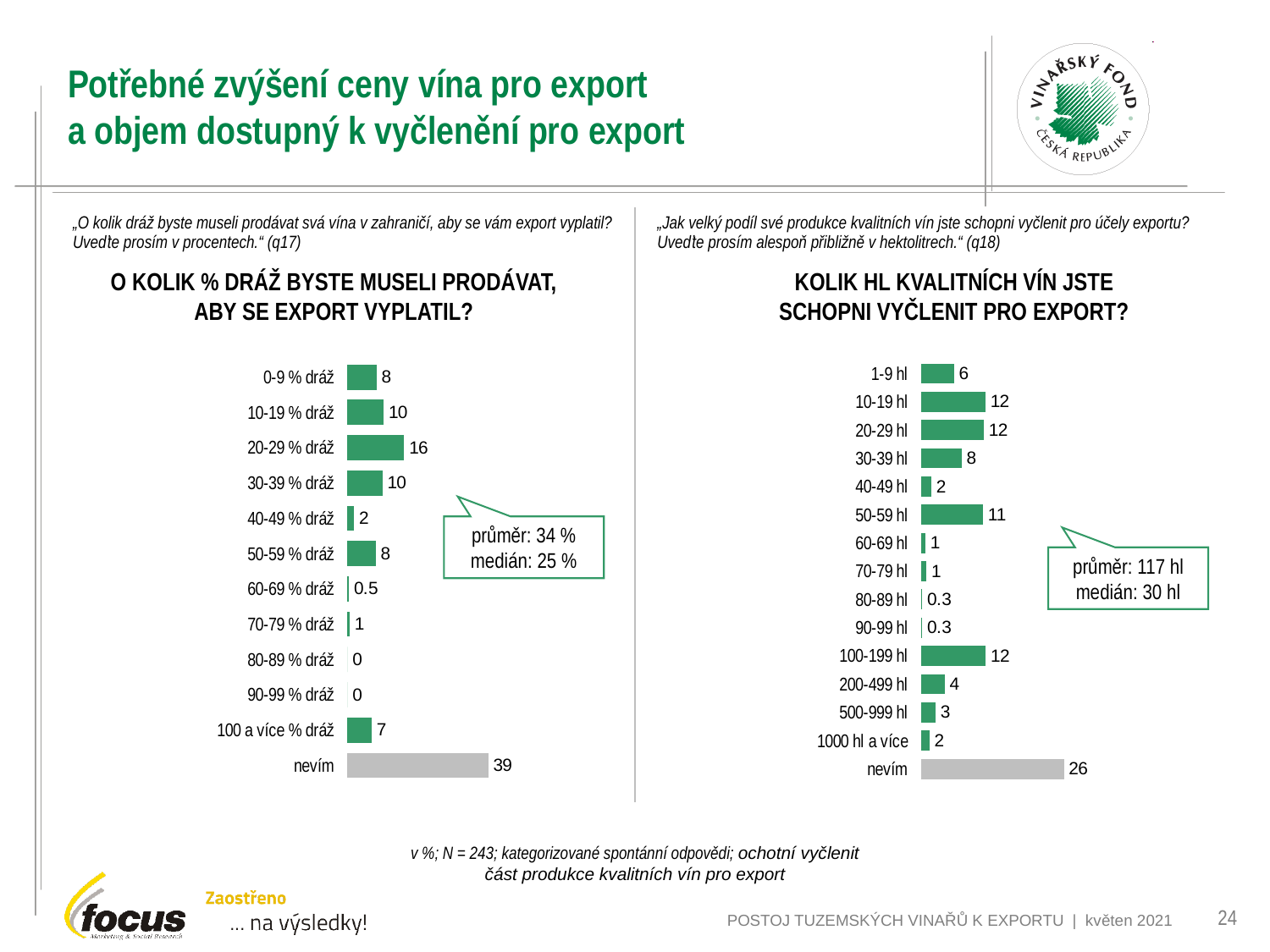
In the left chart (O KOLIK % DRÁŽ BYSTE MUSELI PRODÁVAT, ABY SE EXPORT VYPLATIL?), what is the difference between the values for "20-29 % dráž" and "10-19 % dráž"? 6 In the left chart (O KOLIK % DRÁŽ BYSTE MUSELI PRODÁVAT, ABY SE EXPORT VYPLATIL?), what is the value for "nevím"? 39 In the left chart (O KOLIK % DRÁŽ BYSTE MUSELI PRODÁVAT, ABY SE EXPORT VYPLATIL?), what is the value for "20-29 % dráž"? 16 In the right chart (KOLIK HL KVALITNÍCH VÍN JSTE SCHOPNI VYČLENIT PRO EXPORT?), how many categories are shown? 15 In the right chart (KOLIK HL KVALITNÍCH VÍN JSTE SCHOPNI VYČLENIT PRO EXPORT?), what median value is shown in the callout? 30 hl In the right chart (KOLIK HL KVALITNÍCH VÍN JSTE SCHOPNI VYČLENIT PRO EXPORT?), which is larger, the value for "200-499 hl" or "500-999 hl"? 200-499 hl In the right chart (KOLIK HL KVALITNÍCH VÍN JSTE SCHOPNI VYČLENIT PRO EXPORT?), what is the value for "50-59 hl"? 11 In the left chart (O KOLIK % DRÁŽ BYSTE MUSELI PRODÁVAT, ABY SE EXPORT VYPLATIL?), which category has the highest value? nevím In the left chart (O KOLIK % DRÁŽ BYSTE MUSELI PRODÁVAT, ABY SE EXPORT VYPLATIL?), what is the value for "60-69 % dráž"? 0.5 In the right chart (KOLIK HL KVALITNÍCH VÍN JSTE SCHOPNI VYČLENIT PRO EXPORT?), what is the value for "nevím"? 26 In the left chart (O KOLIK % DRÁŽ BYSTE MUSELI PRODÁVAT, ABY SE EXPORT VYPLATIL?), how many categories are shown? 12 What type of chart is the right chart (KOLIK HL KVALITNÍCH VÍN JSTE SCHOPNI VYČLENIT PRO EXPORT?)? bar chart